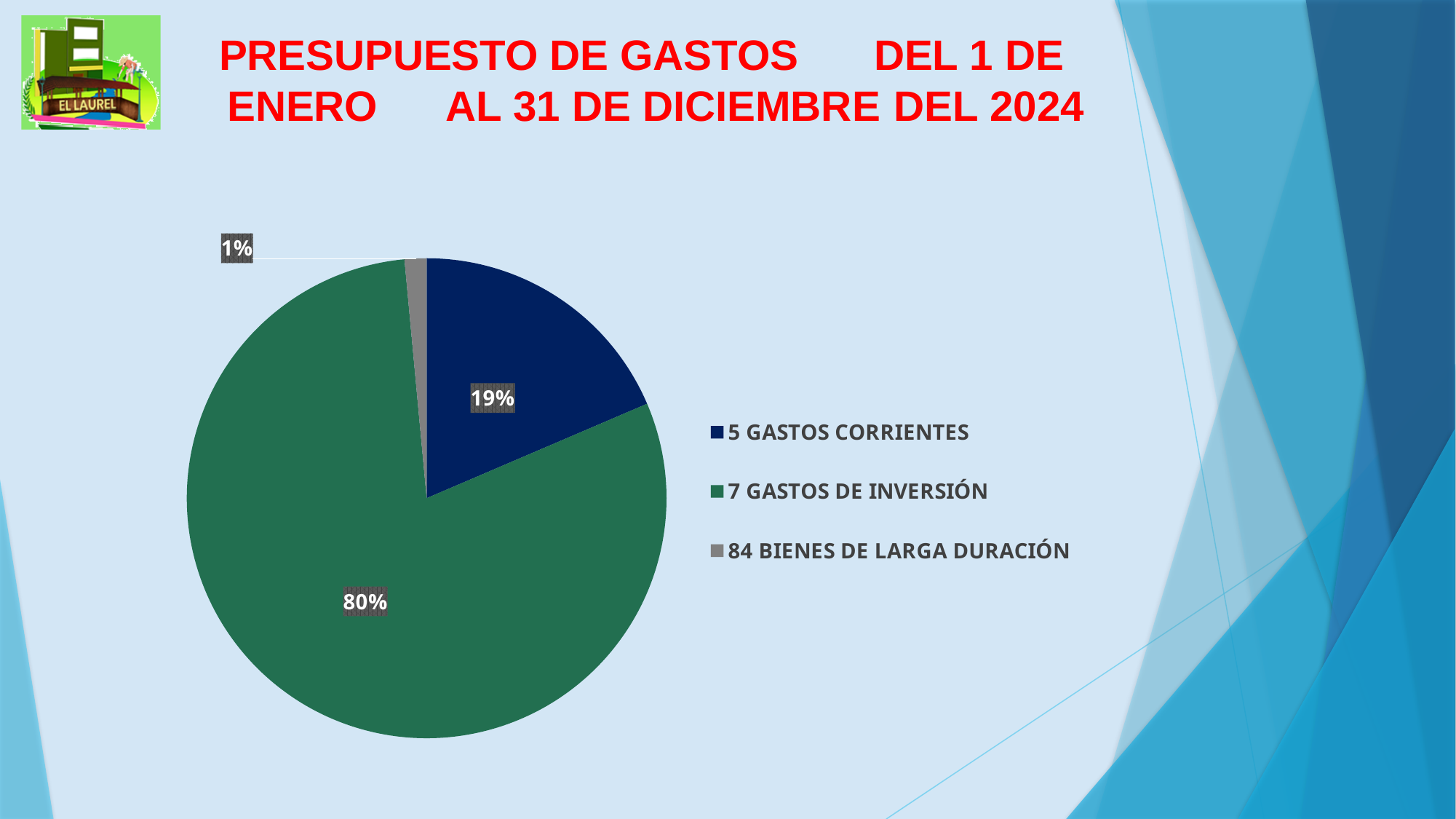
What share of the pie does 7 GASTOS DE INVERSIÓN represent? 80% What share of the pie does 5 GASTOS CORRIENTES represent? 19% Which category has the smallest slice of the pie? 84 BIENES DE LARGA DURACIÓN What is the difference in percentage points between 7 GASTOS DE INVERSIÓN and 5 GASTOS CORRIENTES? 61 What kind of chart is shown on the slide? pie chart Which category has the largest slice of the pie? 7 GASTOS DE INVERSIÓN How many categories does the pie chart show? 3 Which is larger, the slice for 5 GASTOS CORRIENTES or the slice for 84 BIENES DE LARGA DURACIÓN? 5 GASTOS CORRIENTES What share of the pie does 84 BIENES DE LARGA DURACIÓN represent? 1% What is the difference in percentage points between 5 GASTOS CORRIENTES and 84 BIENES DE LARGA DURACIÓN? 18 What is the title of the slide containing the pie chart? PRESUPUESTO DE GASTOS DEL 1 DE ENERO AL 31 DE DICIEMBRE DEL 2024 What colour is the slice for 5 GASTOS CORRIENTES? dark blue